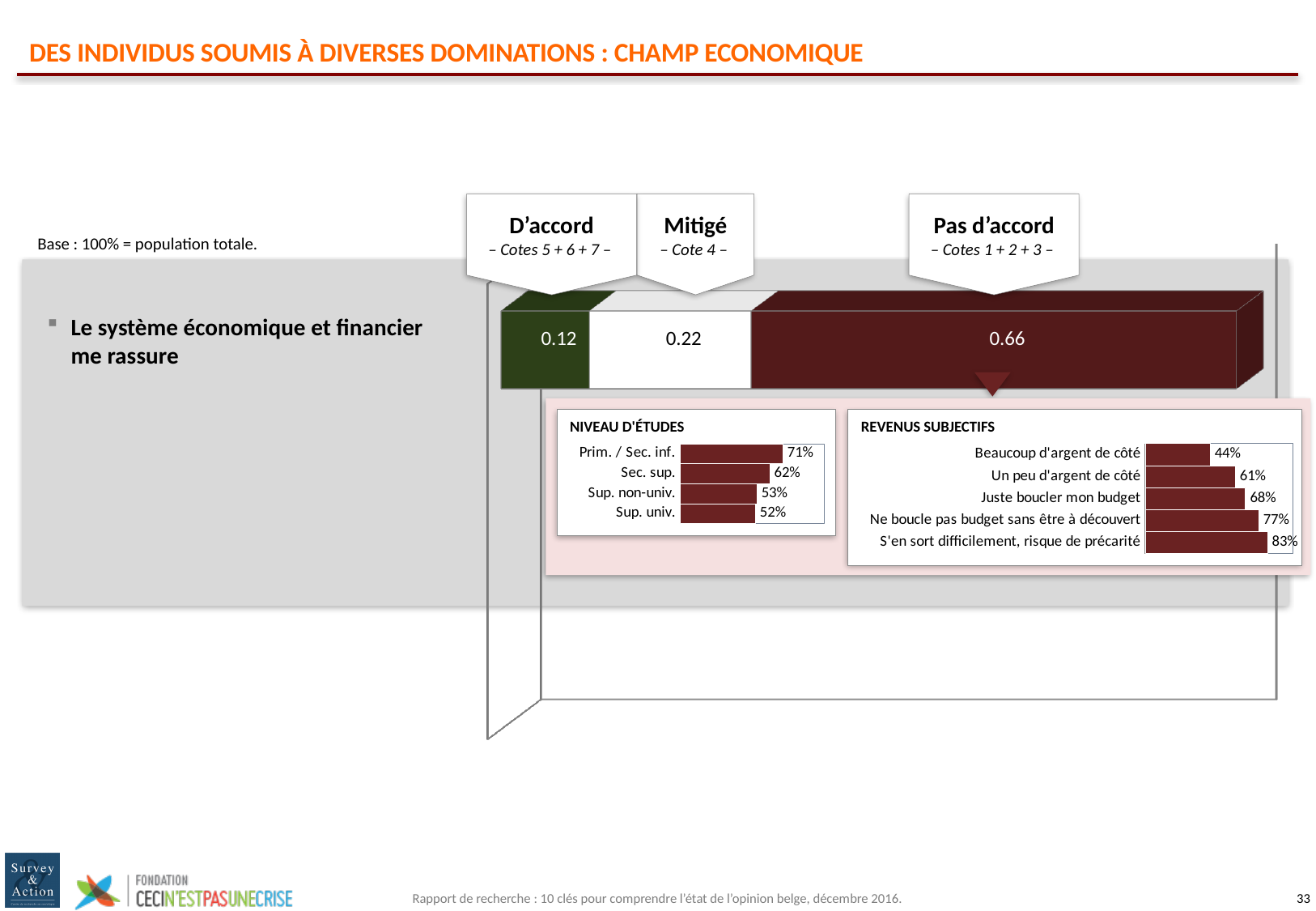
In the "REVENUS SUBJECTIFS" chart, which category has the lowest value? Beaucoup d'argent de côté In the stacked bar for "Le système économique et financier me rassure", which segment is the largest? Pas d'accord In the "NIVEAU D'ÉTUDES" chart, how many categories are shown? 4 In the "REVENUS SUBJECTIFS" chart, do the values rise or fall from the top category to the bottom category? rise In the "NIVEAU D'ÉTUDES" chart, which category has the highest value? Prim. / Sec. inf. In the "NIVEAU D'ÉTUDES" chart, what is the value for "Sec. sup."? 62% In the stacked bar for "Le système économique et financier me rassure", what is the total of the three segments? 1.00 In the stacked bar for "Le système économique et financier me rassure", what is the value for "Pas d'accord"? 0.66 In the stacked bar for "Le système économique et financier me rassure", what is the value for "D'accord"? 0.12 What kind of chart is the "REVENUS SUBJECTIFS" chart? bar chart In the "REVENUS SUBJECTIFS" chart, what is the value for "Juste boucler mon budget"? 68% In the "NIVEAU D'ÉTUDES" chart, what is the difference between "Prim. / Sec. inf." and "Sup. univ."? 19%